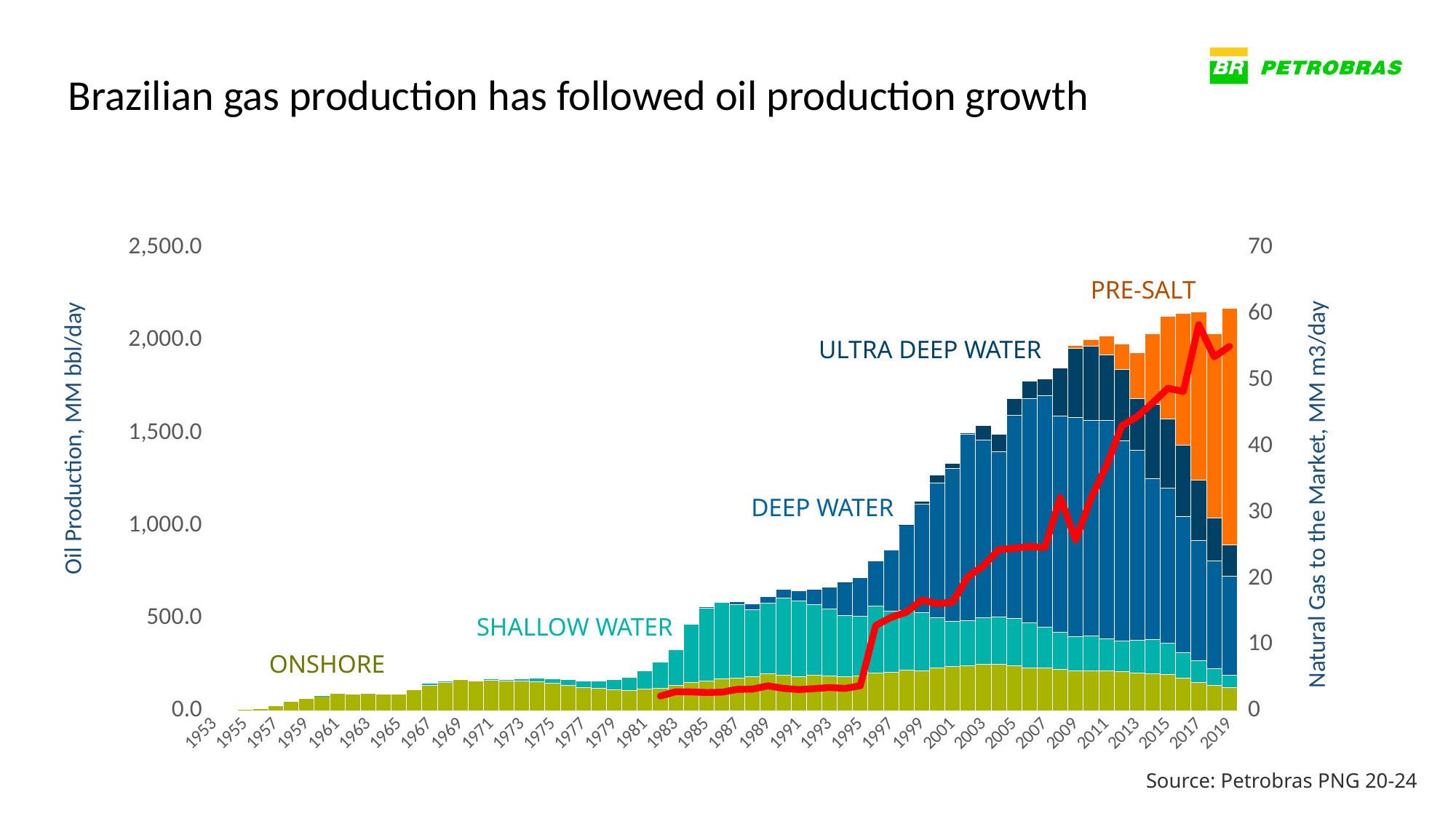
In which year does the red natural gas line reach its highest value? 2017 Is the natural gas value (red line) for 2019 greater or less than 50? greater Which is larger in 2019, the PRE-SALT segment or the ONSHORE segment? PRE-SALT What kind of chart is shown on the slide? Stacked bar chart with a line How many oil production categories are labelled on the stacked bars? 5 Does the red natural gas line generally rise or fall from 1983 to 2019? rise Which oil production category is shown in orange at the top of the stacked bars? PRE-SALT What is the title of the slide's chart? Brazilian gas production has followed oil production growth Is the total oil production for 1995 greater or less than 1,000.0? less What is the label of the right-hand vertical axis? Natural Gas to the Market, MM m3/day Is the total oil production for 2019 greater or less than 2,000.0? greater